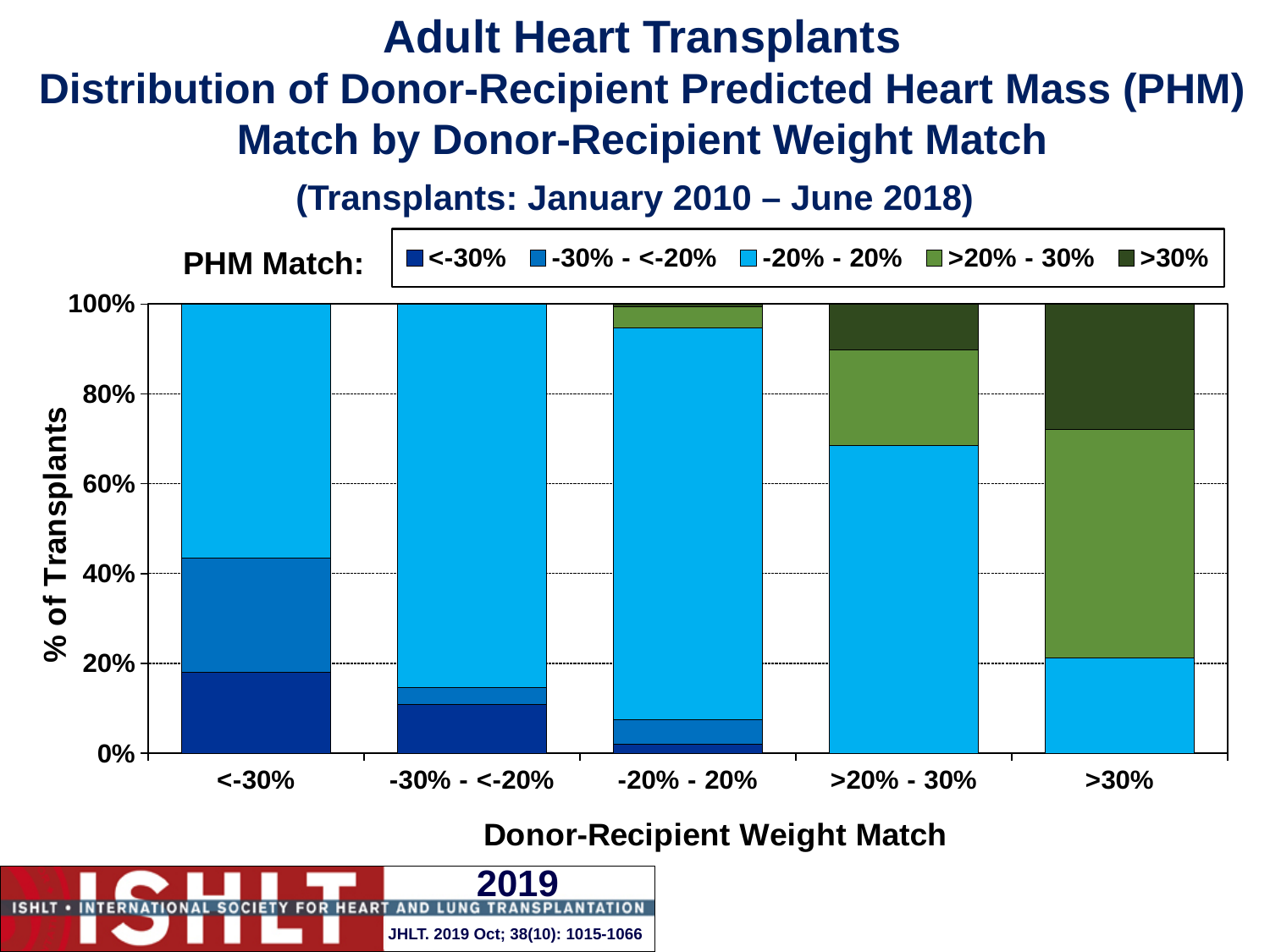
What is the label of the y axis? % of Transplants What kind of chart is shown on the slide? Stacked bar chart How many PHM Match series does the legend list? 5 What transplant period is given in the chart title? January 2010 – June 2018 Moving from the <-30% to the >30% weight match category, does the share of transplants with a PHM Match of <-30% rise or fall? fall Which Donor-Recipient Weight Match category has the largest share of transplants with a PHM Match of <-30%? <-30% How many Donor-Recipient Weight Match categories are shown on the x axis? 5 In the >30% weight match category, which PHM Match segment is larger: >20% - 30% or >30%? >20% - 30% In the <-30% weight match category, is the share of transplants with a PHM Match of <-30% greater or less than 20%? less Which Donor-Recipient Weight Match category has the largest share of transplants with a PHM Match of >30%? >30% In the -20% - 20% weight match category, is the share of transplants with a PHM Match of -20% - 20% greater or less than 80%? greater In the >20% - 30% weight match category, is the share of transplants with a PHM Match of -20% - 20% greater or less than 60%? greater